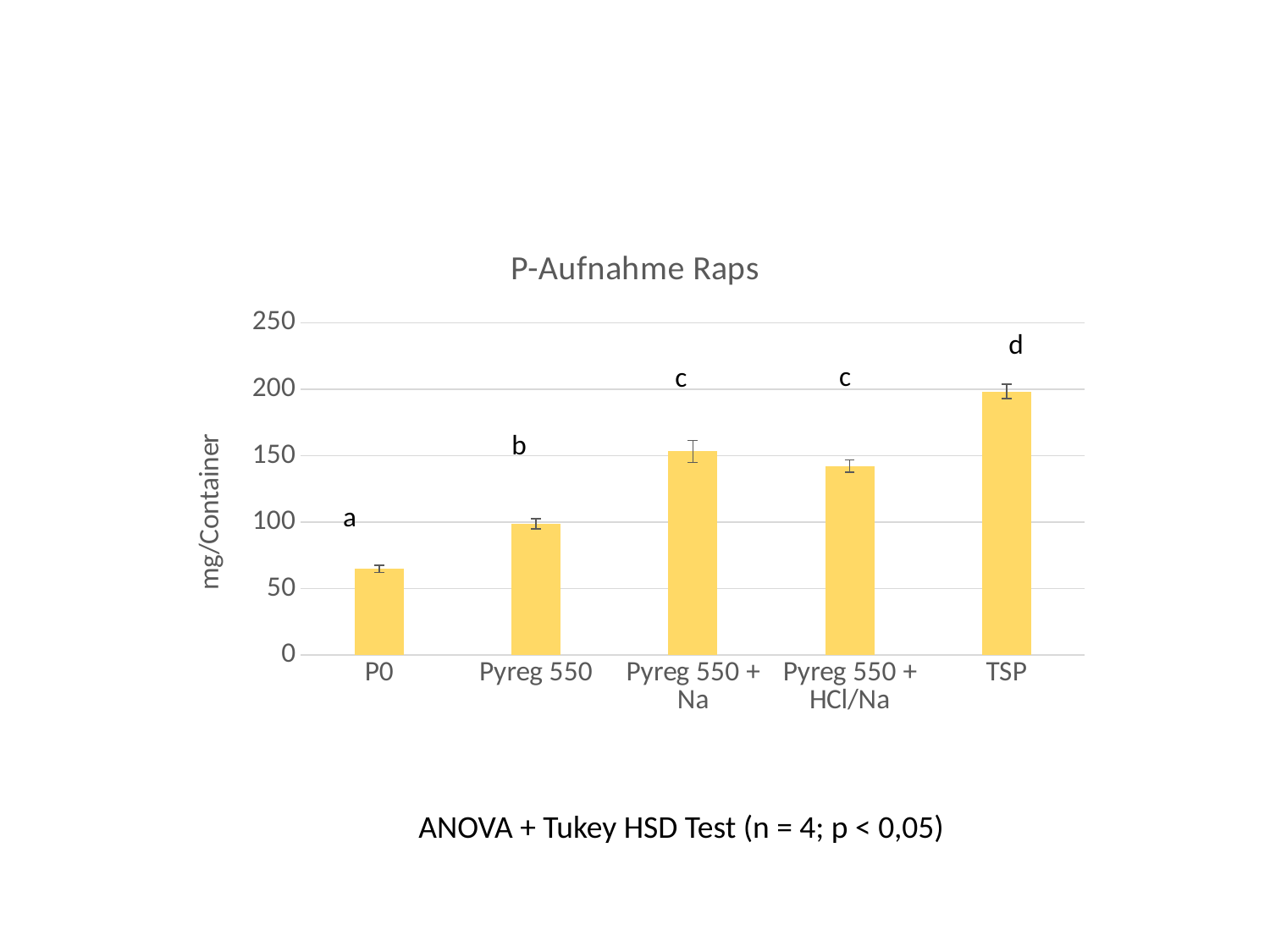
Is the value for P0 greater or less than 100? less How many categories are shown on the x axis? 5 Which category has the highest value? TSP Which category has the lowest value? P0 What kind of chart is shown on the slide? bar chart What is the title of the chart? P-Aufnahme Raps Is the value for Pyreg 550 + HCl/Na greater or less than 150? less What is the label of the vertical axis? mg/Container Which is larger, the value for Pyreg 550 + Na or the value for Pyreg 550 + HCl/Na? Pyreg 550 + Na Is the value for P0 greater or less than 50? greater Does the value rise or fall from P0 to Pyreg 550? rise